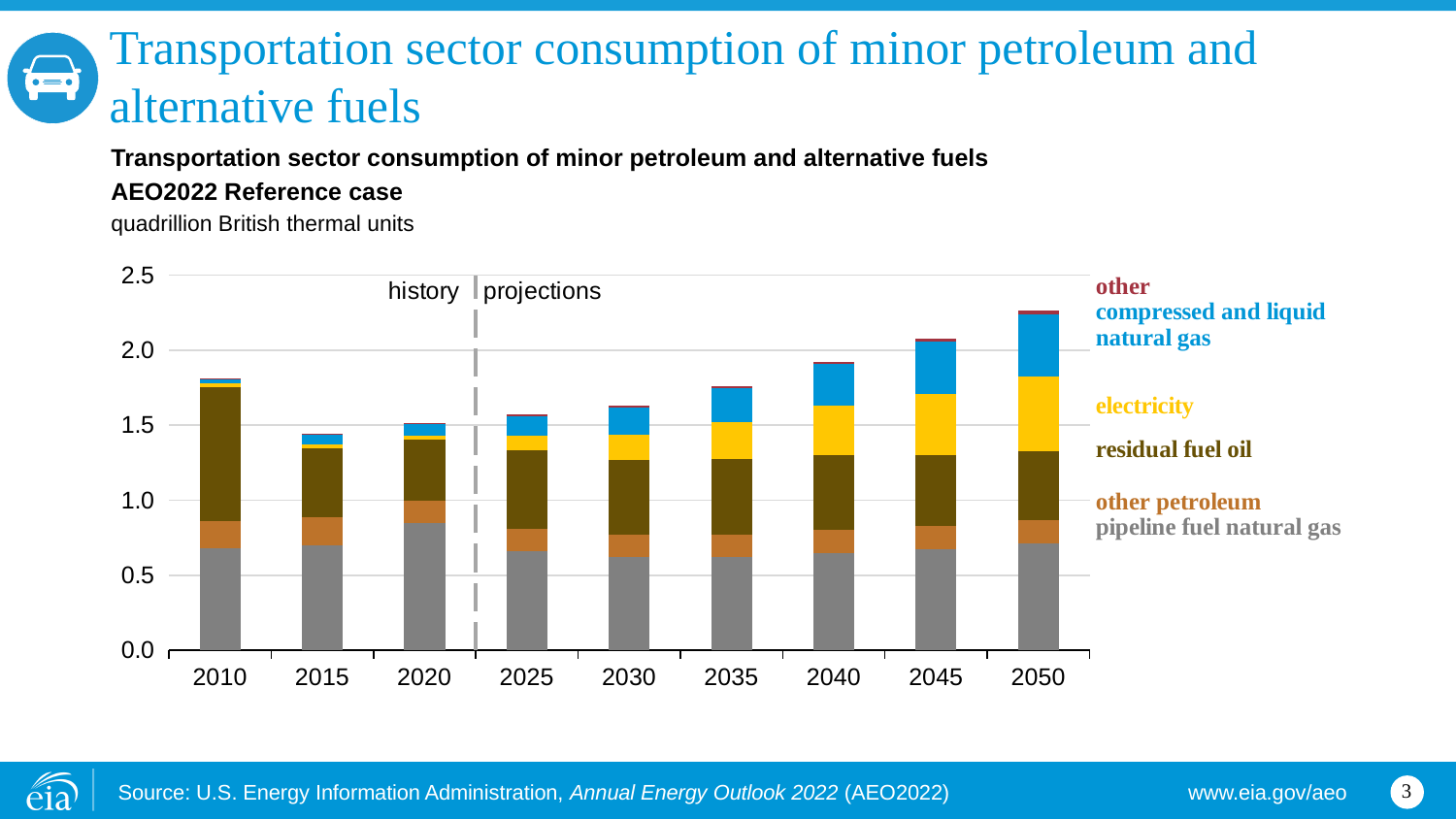
Is the total consumption for 2010 greater or less than 1.5 quadrillion Btu? greater How many years are shown along the x axis of the chart? 9 Do total consumption values rise or fall across the projection years from 2025 to 2050? rise Is the total consumption for 2050 greater or less than 2.0 quadrillion Btu? greater What unit is the chart's y axis measured in? quadrillion British thermal units Which year has the highest total consumption of minor petroleum and alternative fuels? 2050 What kind of chart is shown on the slide? stacked bar chart Is the total consumption for 2015 greater or less than 1.5 quadrillion Btu? less Which legend entry is shown in yellow? electricity Which year has the larger total consumption, 2010 or 2015? 2010 How many fuel series does the chart's legend list? 6